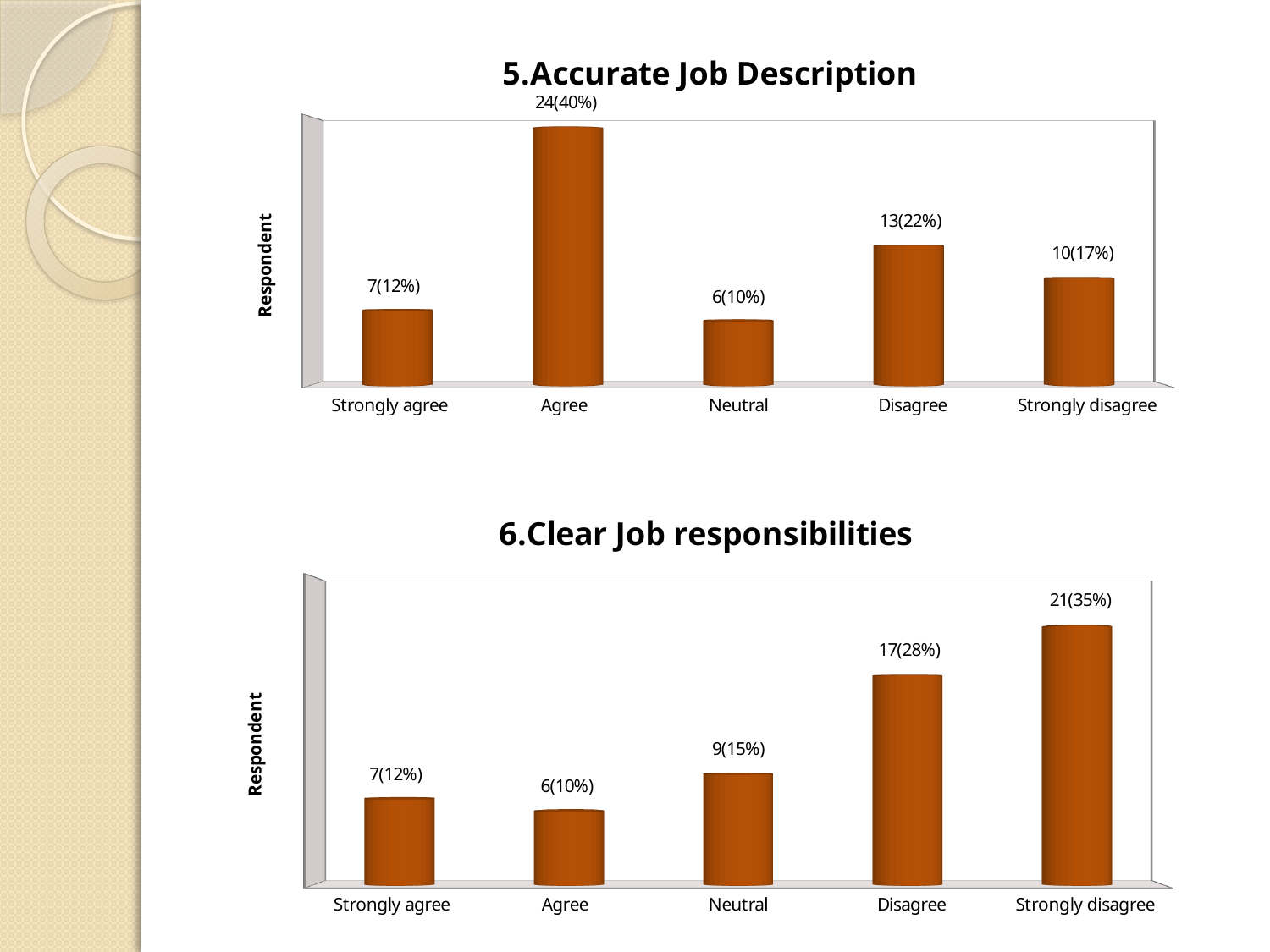
What is the y-axis label on the '6.Clear Job responsibilities' chart? Respondent In the '5.Accurate Job Description' chart, which category has the lowest value? Neutral In the '6.Clear Job responsibilities' chart, what is the data label for Strongly disagree? 21(35%) In the '5.Accurate Job Description' chart, what is the data label for Agree? 24(40%) In the '6.Clear Job responsibilities' chart, which category has the highest value? Strongly disagree In the '5.Accurate Job Description' chart, what is the difference in respondent count between Disagree and Strongly disagree? 3 In the '6.Clear Job responsibilities' chart, which is larger, Neutral or Disagree? Disagree In the '6.Clear Job responsibilities' chart, what is the difference in respondent count between Strongly disagree and Disagree? 4 In the '6.Clear Job responsibilities' chart, which category has the lowest value? Agree What type of chart is the '5.Accurate Job Description' chart? Bar chart In the '5.Accurate Job Description' chart, what is the data label for Strongly agree? 7(12%) In the '5.Accurate Job Description' chart, how many categories are shown on the x axis? 5